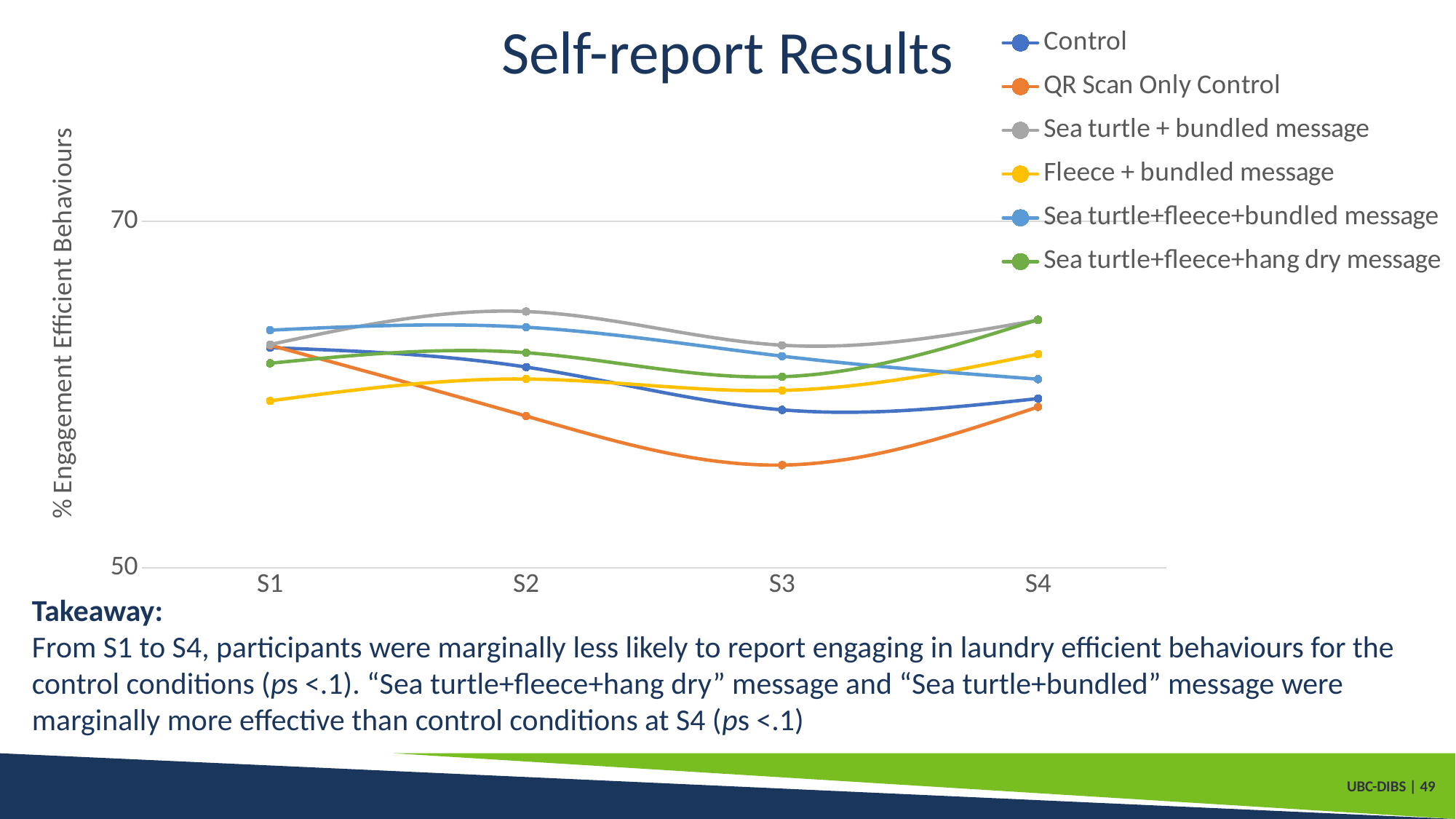
Which series has the lowest value at S1? Fleece + bundled message Does the Fleece + bundled message series rise or fall from S1 to S4? rise What kind of chart is shown on the slide? line chart At S2, which is larger: QR Scan Only Control or Fleece + bundled message? Fleece + bundled message At S3, which is larger: Sea turtle + bundled message or Control? Sea turtle + bundled message What is the label on the y axis? % Engagement Efficient Behaviours How many time points are shown along the x axis? 4 Is the value for QR Scan Only Control at S3 greater or less than 70? less Which series has the lowest value at S3? QR Scan Only Control Does the Control series rise or fall from S1 to S4? fall How many series does the legend list? 6 Which series has the highest value at S2? Sea turtle + bundled message